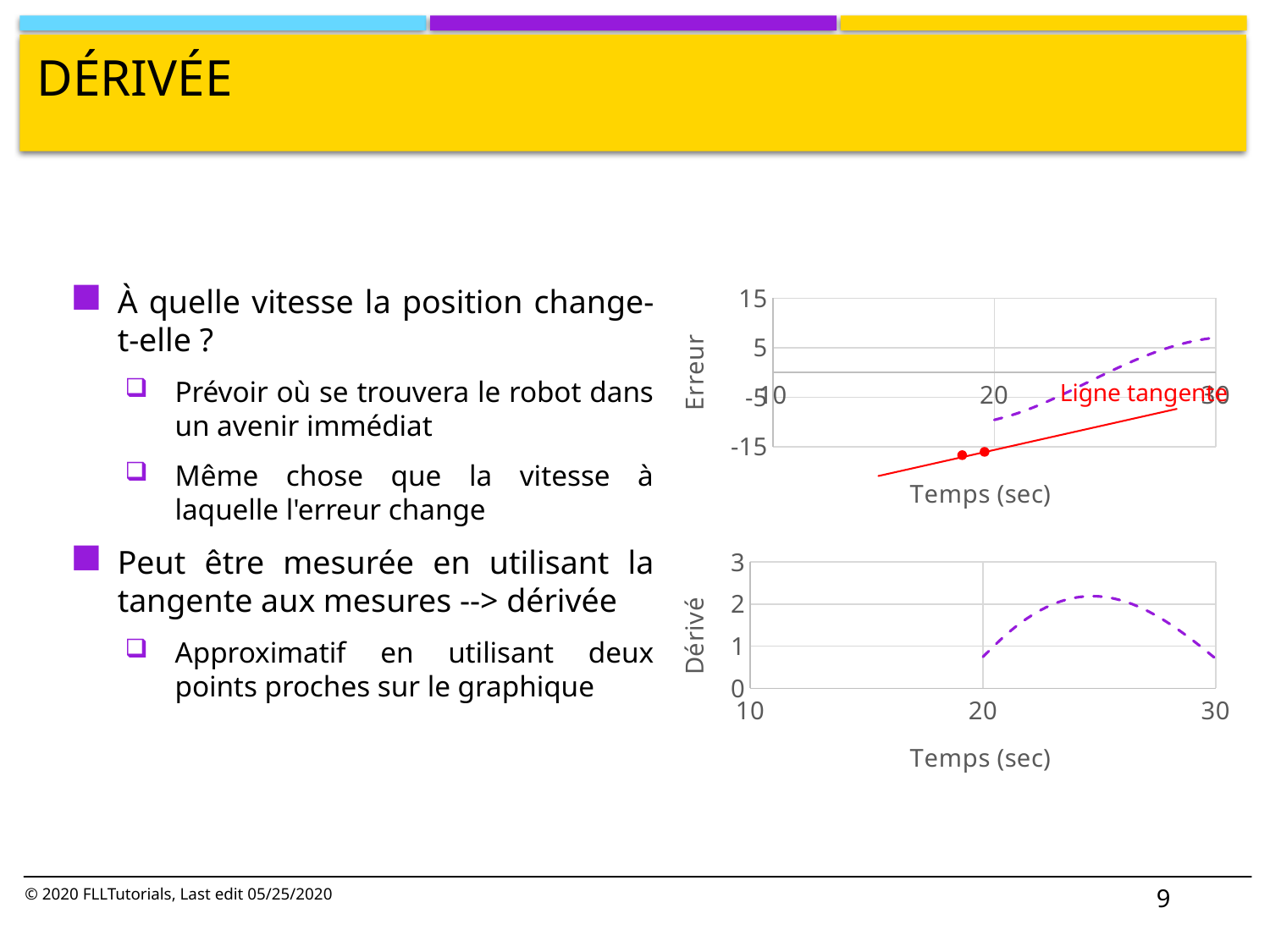
In the bottom chart, is the value of the dashed curve at 25 seconds greater or less than 1? greater In the top chart, is the value of the dashed curve at 20 seconds greater or less than -5? less What kind of chart is the bottom chart (Dérivé vs Temps)? line chart How many charts are shown on the slide? 2 In the bottom chart, what is the label of the horizontal axis? Temps (sec) In the top chart, does the dashed curve rise or fall as time goes from 20 to 30 seconds? rise In the bottom chart, is the value of the dashed curve at 20 seconds greater or less than 1? less In the top chart, what is the label attached to the red straight line? Ligne tangente In the top chart, what is the label of the vertical axis? Erreur In the bottom chart, does the dashed curve rise or fall as time goes from 25 to 30 seconds? fall What kind of chart is the top chart (Erreur vs Temps)? line chart In the top chart, how many red dots are marked on the tangent line? 2